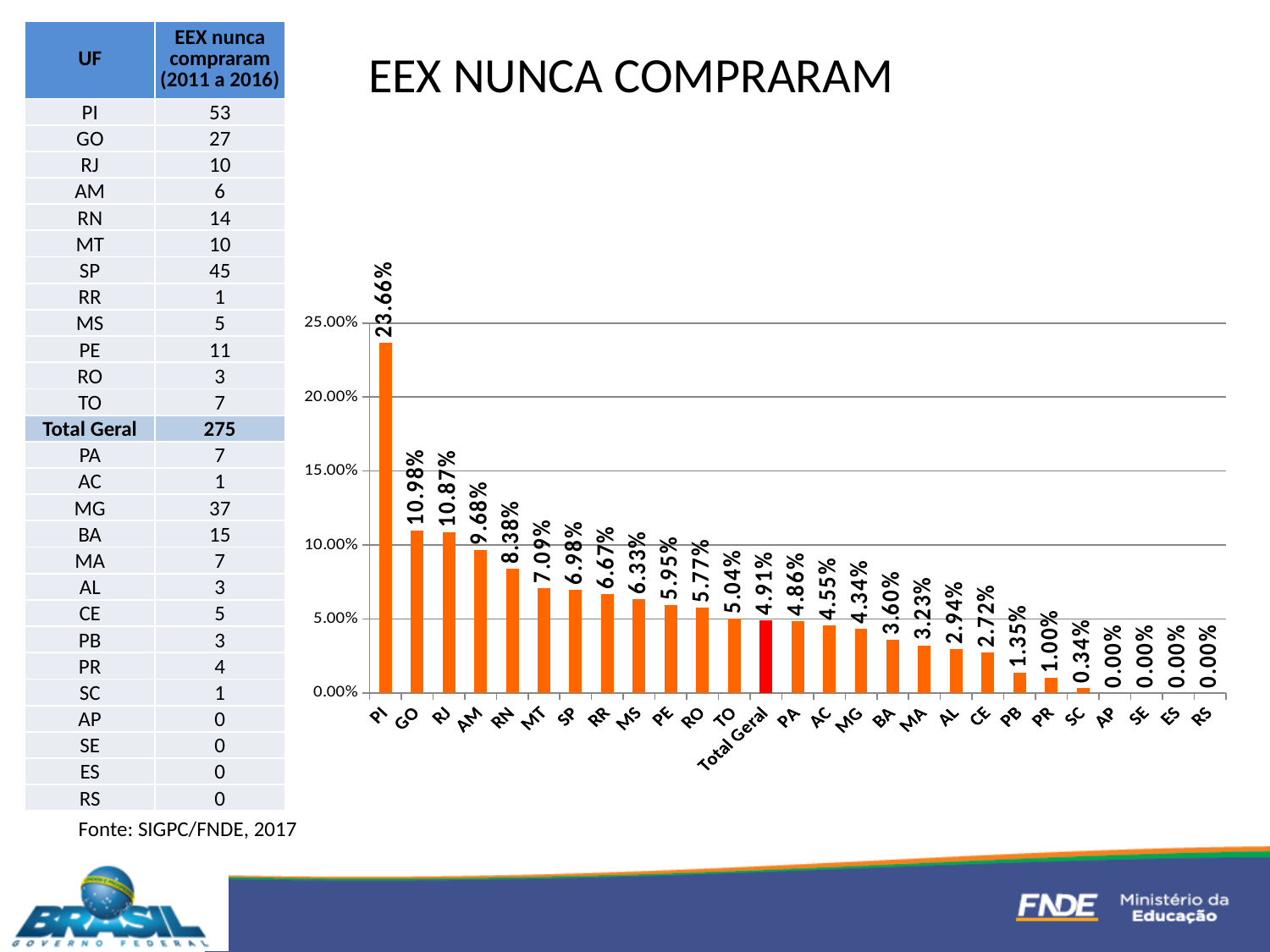
How many bars are plotted in the chart? 27 What is the difference between the values for PI and GO? 12.68% What kind of chart is shown on the slide? bar chart What is the difference between the values for GO and RJ? 0.11% What is the value for PI in the chart? 23.66% Which bar in the chart is coloured red instead of orange? Total Geral Is the value for PI greater or less than 20.00%? greater What is the value shown for Total Geral in the chart? 4.91% What is the value for MG in the chart? 4.34% What is the lowest value shown in the chart? 0.00% Which category has the highest value in the chart? PI Which is larger, the value for SP or the value for MT? MT